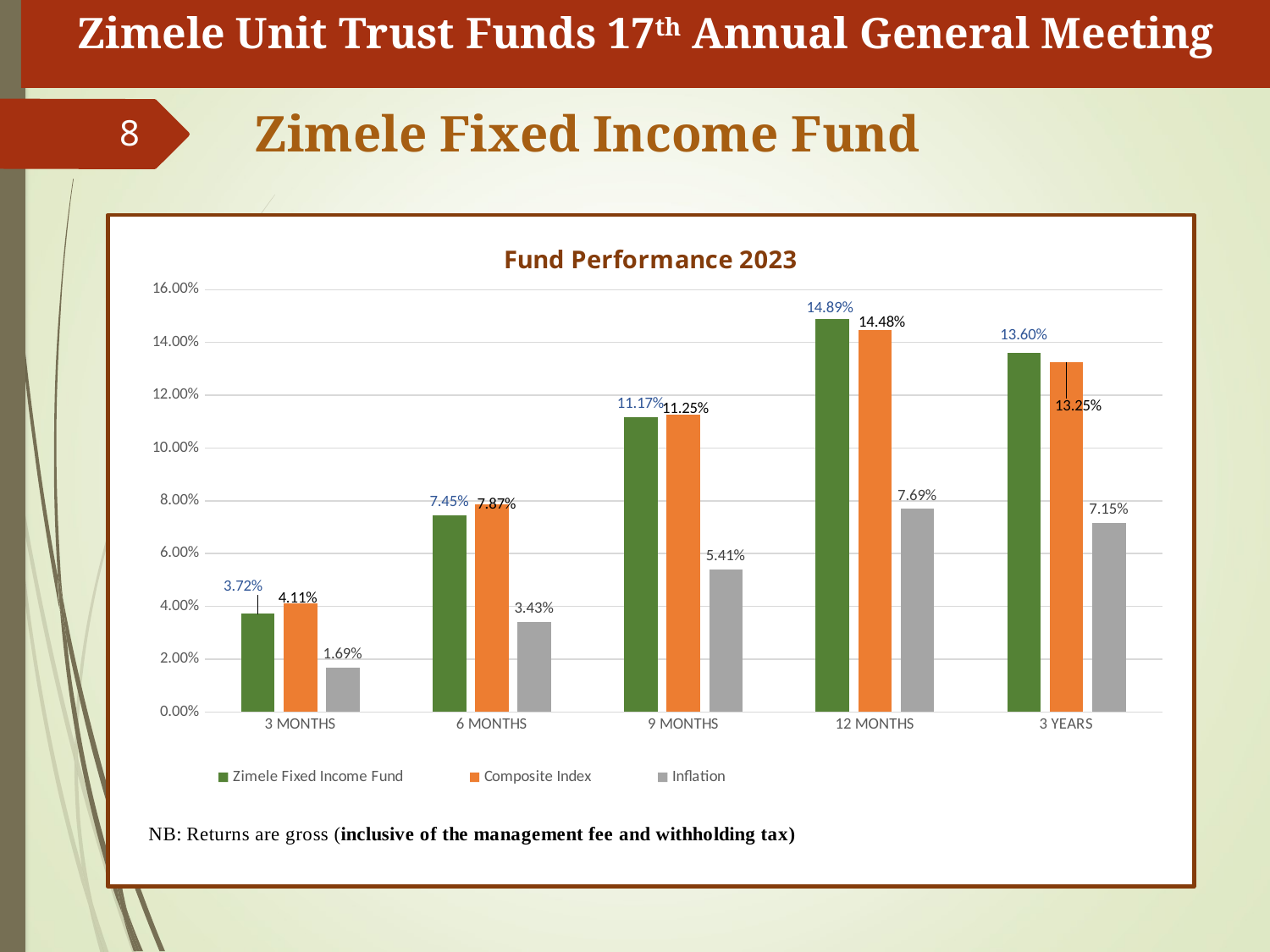
What kind of chart is shown on the slide? Bar chart Does the Zimele Fixed Income Fund value rise or fall from 3 MONTHS to 12 MONTHS? Rise What is the Inflation value at 9 MONTHS? 5.41% What is the difference between the Zimele Fixed Income Fund and Composite Index values at 12 MONTHS? 0.41% How many periods are shown on the x axis? 5 At which period is the Zimele Fixed Income Fund value lowest? 3 MONTHS At 3 MONTHS, which is larger: Zimele Fixed Income Fund or Composite Index? Composite Index What is the value for Zimele Fixed Income Fund at 12 MONTHS? 14.89% What is the difference between Inflation at 12 MONTHS and Inflation at 3 MONTHS? 6.00% How many series does the legend list? 3 At which period is Inflation highest? 12 MONTHS What is the Composite Index value at 3 YEARS? 13.25%